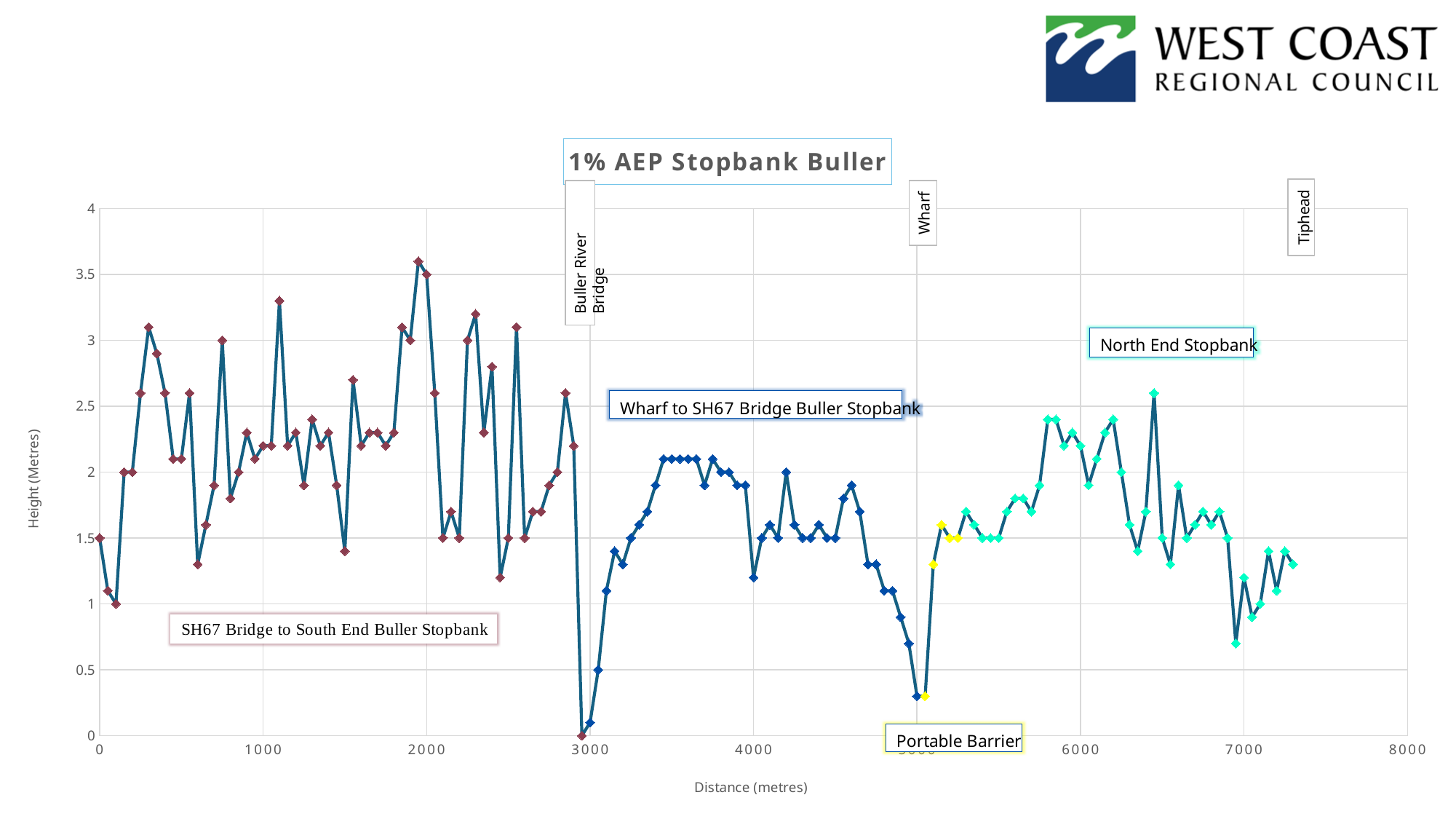
Is the height at a distance of 2000 metres greater or less than 2? greater Is the height at a distance of 0 metres greater or less than 1? greater What is the title of the chart? 1% AEP Stopbank Buller What is the label on the vertical axis of the chart? Height (Metres) Is the height at a distance of 7000 metres greater or less than 1.5? less Do the heights rise or fall along the x axis between 4600 and 5000 metres? fall What kind of chart is shown on the slide? line chart Do the heights rise or fall along the x axis between 5000 and 5800 metres? rise